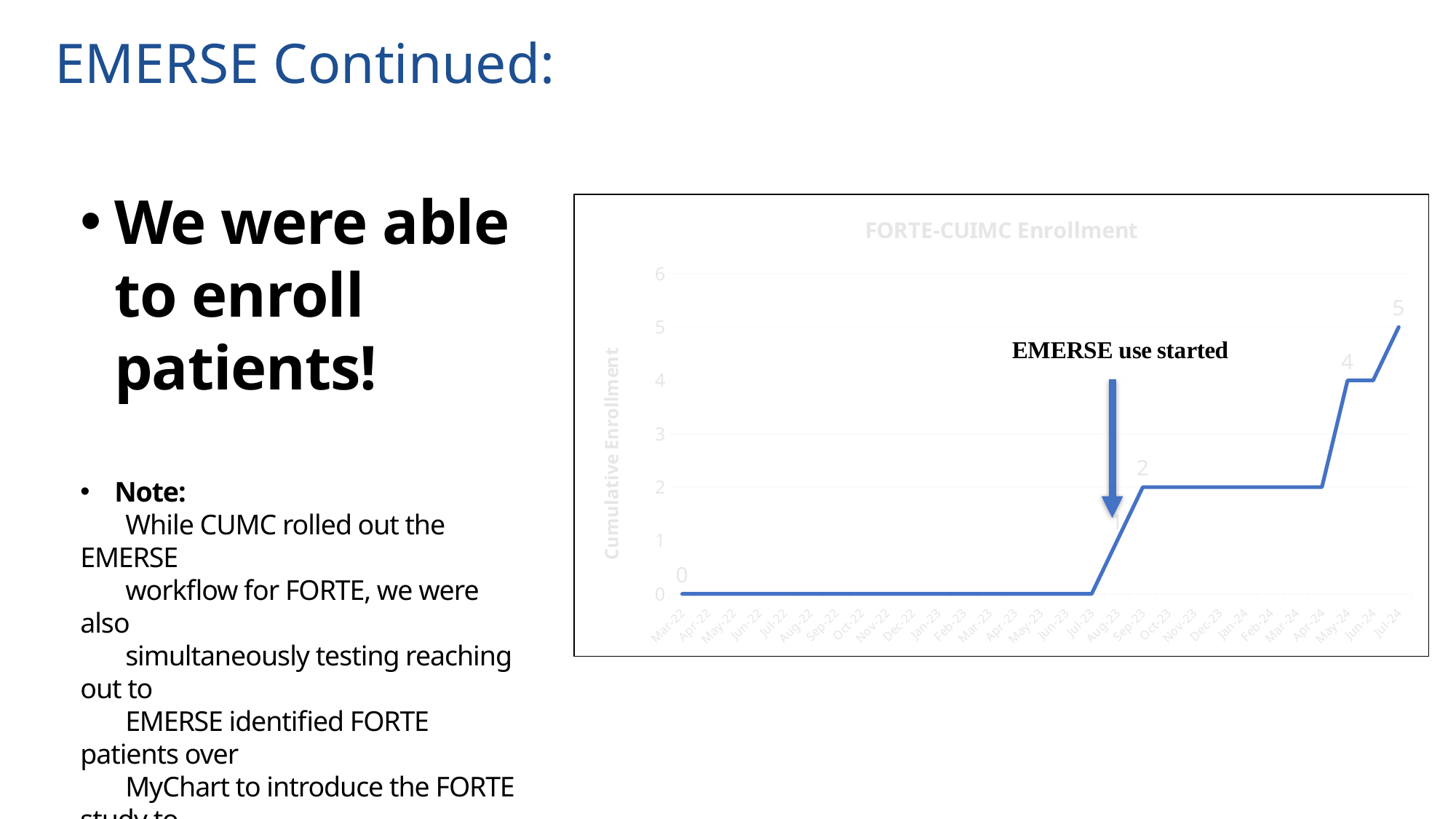
What is the title of the chart? FORTE-CUIMC Enrollment What is the cumulative enrollment value at Sep-23? 2 What kind of chart is shown on the slide? Line chart Does the cumulative enrollment rise or fall over time along the x axis? Rise What is the cumulative enrollment value at Mar-22? 0 What is the cumulative enrollment value at May-24? 4 Is the cumulative enrollment at Jan-24 greater or less than 3? less What is the difference between the cumulative enrollment at Jul-24 and at Sep-23? 3 What is the label on the vertical axis of the chart? Cumulative Enrollment Which is larger, the cumulative enrollment at May-24 or at Sep-23? May-24 What is the cumulative enrollment value at Jul-24? 5 At which month does the cumulative enrollment reach its highest value? Jul-24